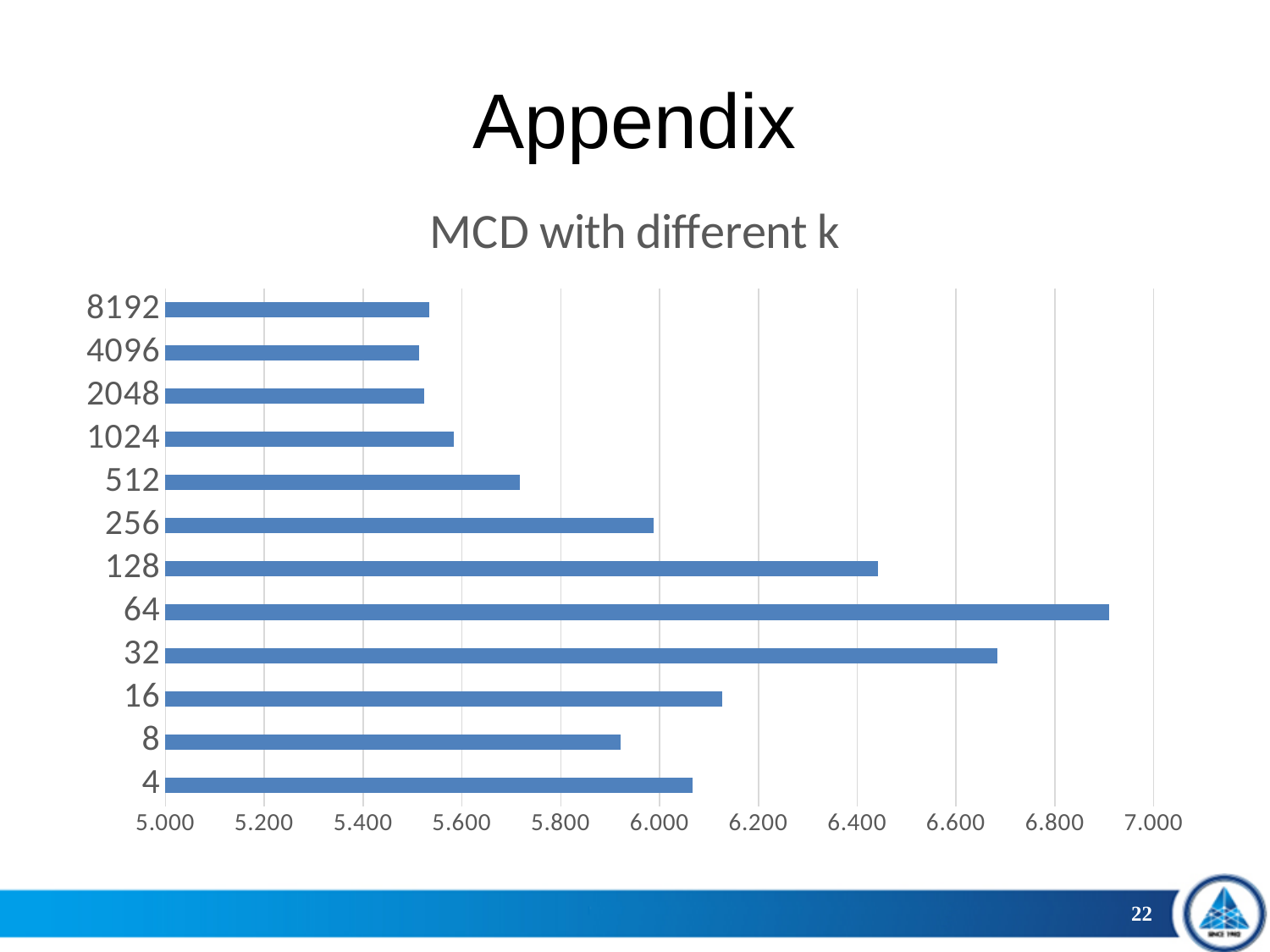
Is the value for k = 128 greater or less than 6.400? greater Which has the larger value, k = 512 or k = 1024? 512 Is the value for k = 512 greater or less than 5.800? less Is the value for k = 8 greater or less than 6.000? less What is the title of the chart? MCD with different k Which value of k has the highest MCD in the chart? 64 Which has the larger value, k = 64 or k = 32? 64 What kind of chart is shown on the slide? bar chart Which has the larger value, k = 128 or k = 16? 128 How many categories (values of k) are plotted in the chart? 12